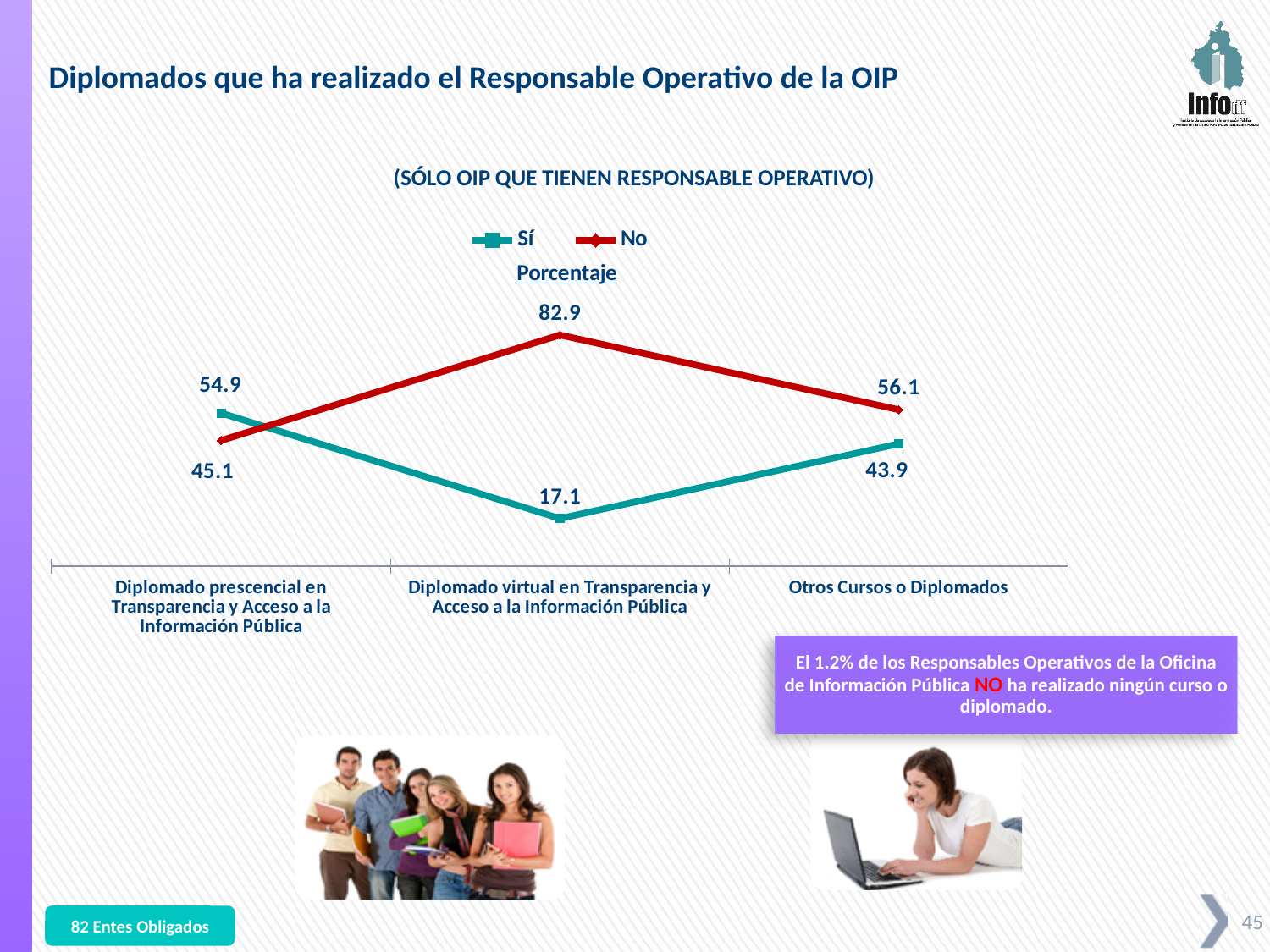
Does the Sí series rise or fall from Diplomado virtual en Transparencia y Acceso a la Información Pública to Otros Cursos o Diplomados? Rise How many series does the legend list? 2 What type of chart is shown on the slide? Line chart For Diplomado prescencial en Transparencia y Acceso a la Información Pública, which series has the larger value, Sí or No? Sí What is the difference between the No and Sí values for Diplomado virtual en Transparencia y Acceso a la Información Pública? 65.8 Which category has the highest value in the No series? Diplomado virtual en Transparencia y Acceso a la Información Pública How many categories are shown on the x axis? 3 Which category has the lowest value in the Sí series? Diplomado virtual en Transparencia y Acceso a la Información Pública What is the value of the Sí series for Otros Cursos o Diplomados? 43.9 What is the value of the Sí series for Diplomado prescencial en Transparencia y Acceso a la Información Pública? 54.9 What is the value of the No series for Diplomado virtual en Transparencia y Acceso a la Información Pública? 82.9 What colour is the line for the No series? Red